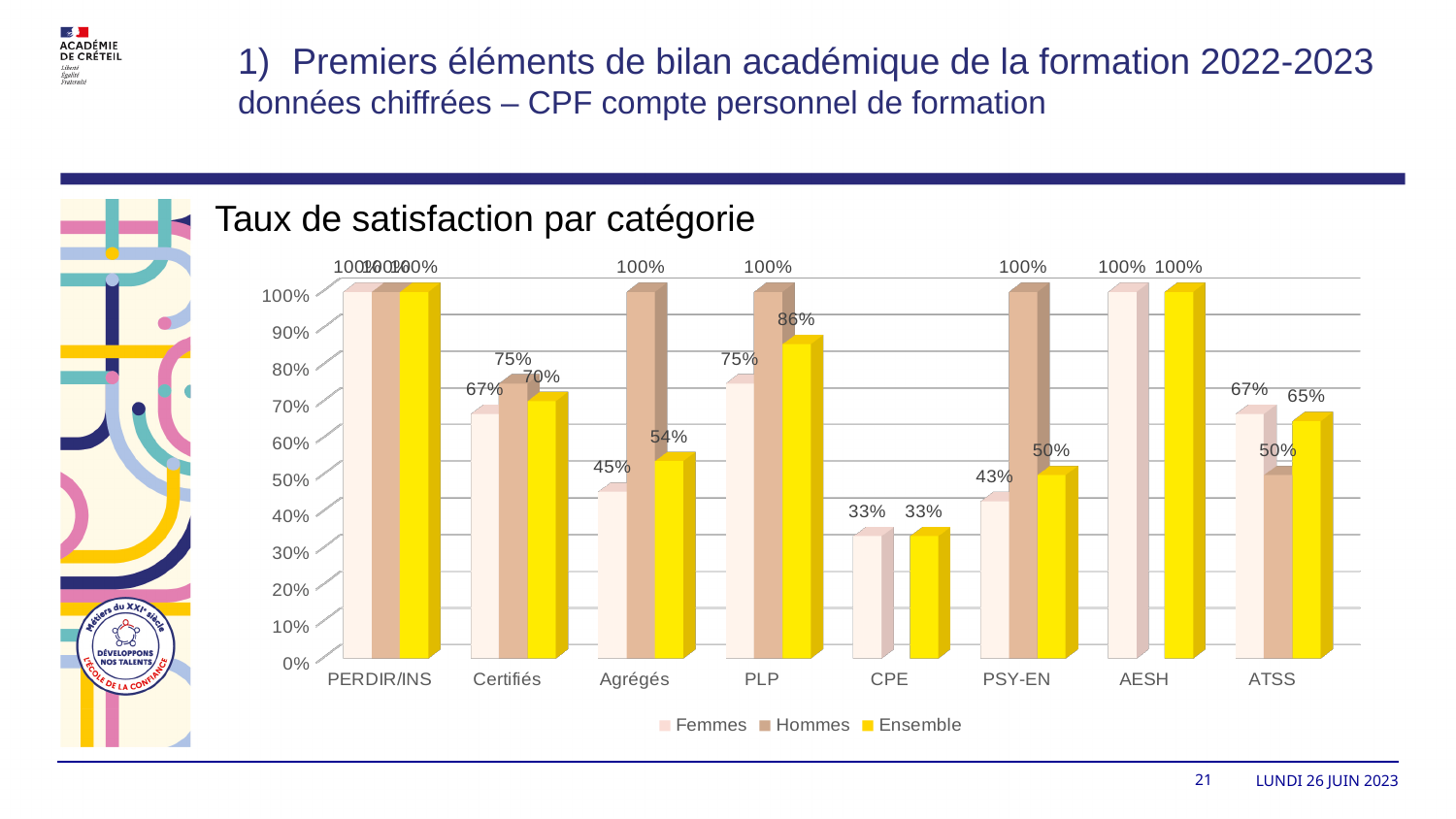
What is the Femmes satisfaction rate for Agrégés? 45% What is the Hommes satisfaction rate for ATSS? 50% What is the title of the chart? Taux de satisfaction par catégorie What is the Ensemble satisfaction rate for Certifiés? 70% How many categories are shown on the x axis? 8 How many series does the legend list? 3 Which is higher for Certifiés, the Femmes rate or the Hommes rate? Hommes What is the Ensemble satisfaction rate for PLP? 86% Which category has the lowest Ensemble satisfaction rate? CPE What is the difference between the Ensemble satisfaction rates for PLP and PSY-EN? 36% What is the difference between the Hommes and Femmes satisfaction rates for Agrégés? 55% What type of chart is shown? Bar chart